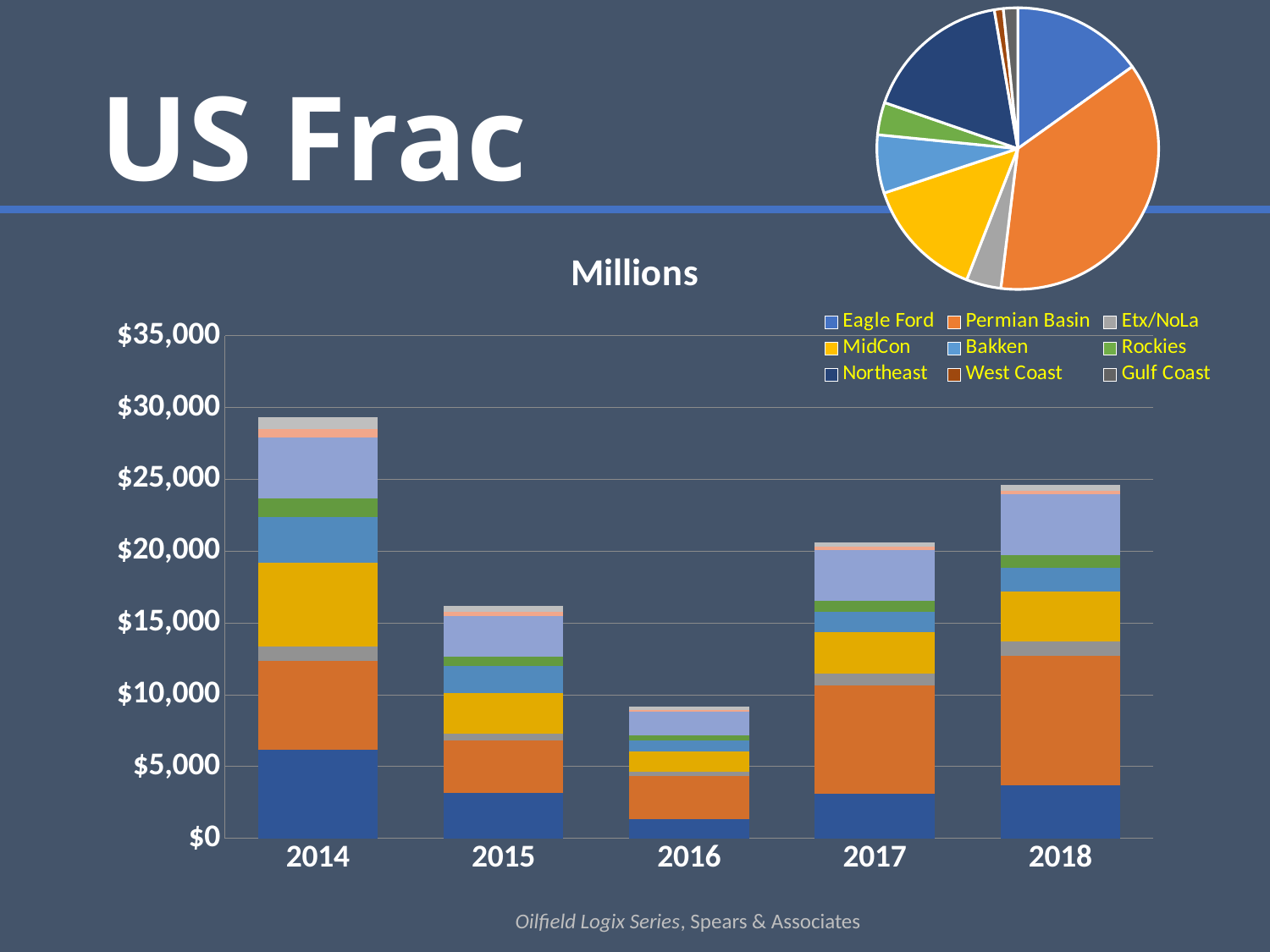
What kind of chart is shown in the top right corner of the slide? pie chart In the chart titled "Millions", which year has the larger total, 2015 or 2017? 2017 In the chart titled "Millions", is the total for 2014 greater or less than $25,000? greater In the chart titled "Millions", which year has the larger total, 2017 or 2018? 2018 In the chart titled "Millions", which year has the shortest stacked bar? 2016 In the chart titled "Millions", how many series does the legend list? 9 In the chart titled "Millions", do the bar totals rise or fall from 2016 to 2018? rise In the chart titled "Millions", how many years are shown on the x axis? 5 In the chart titled "Millions", is the total for 2015 greater or less than $20,000? less In the chart titled "Millions", which year has the tallest stacked bar? 2014 What kind of chart is the chart titled "Millions"? stacked bar chart In the chart titled "Millions", is the total for 2016 greater or less than $10,000? less